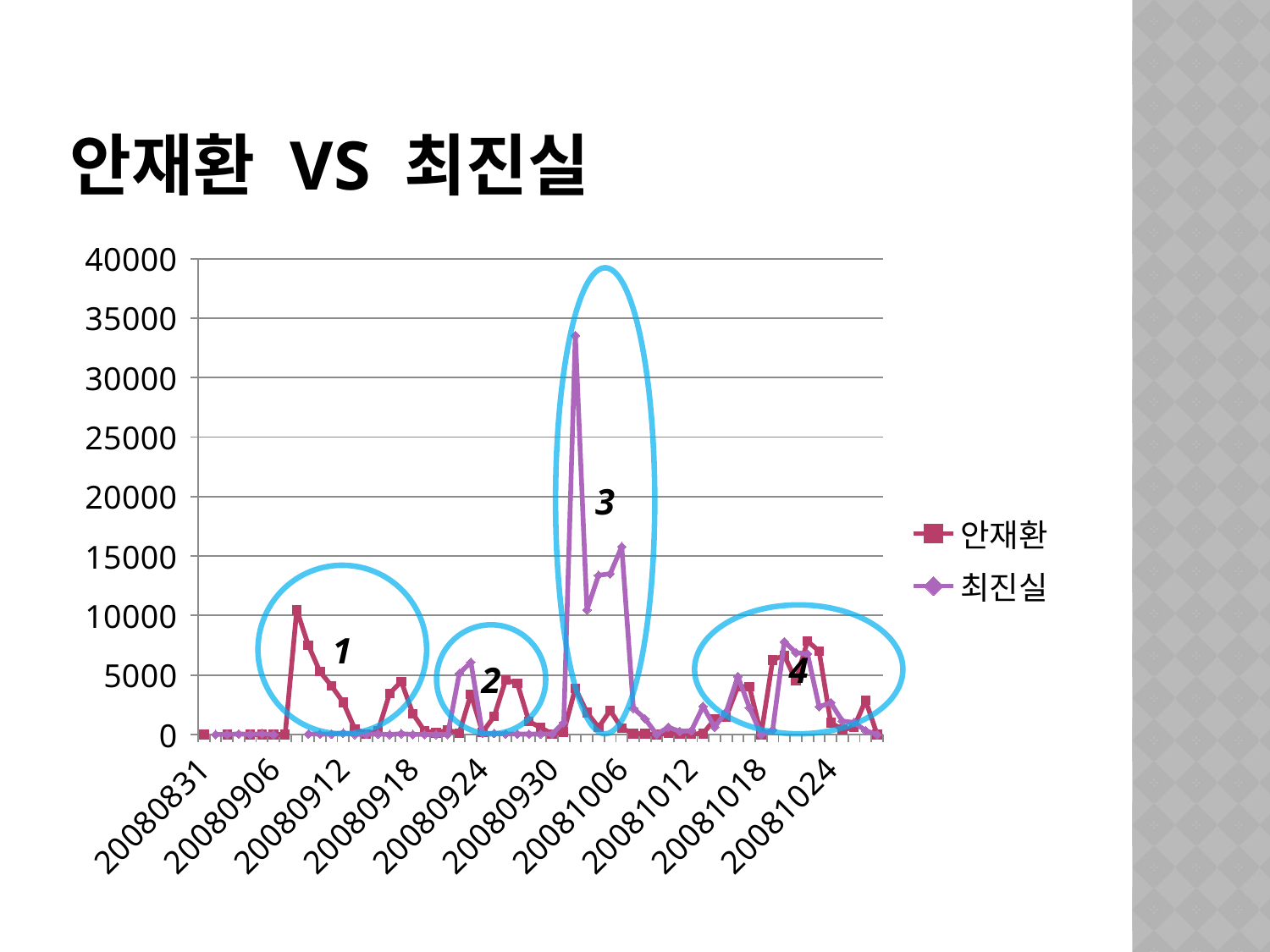
How many series does the legend list? 2 Is the highest value for 최진실 greater or less than 30000? greater Is the highest value for 안재환 greater or less than 15000? less Is the peak of 안재환 inside circle 1 greater or less than 5000? greater What kind of chart is shown on the slide? line chart How many numbered circles are drawn on the chart? 4 Which series reaches the highest value on the chart? 최진실 What is the highest value shown on the y axis? 40000 How many date labels are shown on the x axis? 10 What is the title of the slide? 안재환 VS 최진실 What are the two series named in the legend? 안재환, 최진실